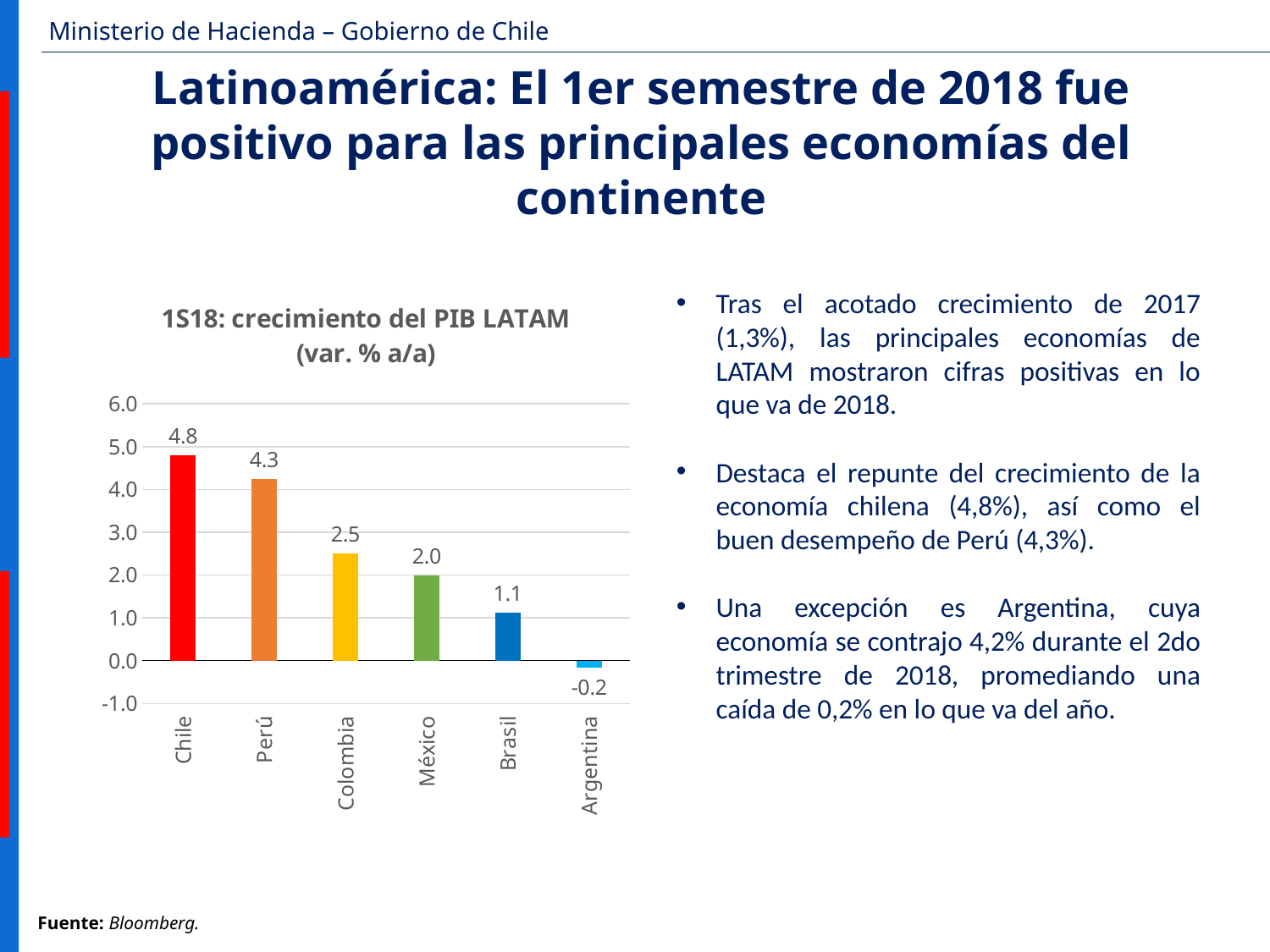
Is the value for Colombia greater or less than 3.0? less What is the value for Perú in the chart? 4.3 What is the difference between the values for Chile and Perú? 0.5 How many countries are shown in the chart? 6 What is the value for Argentina in the chart? -0.2 Which is larger, the value for México or the value for Brasil? México What is the title of the chart? 1S18: crecimiento del PIB LATAM (var. % a/a) What kind of chart is shown on the slide? bar chart What is the value for Chile in the chart? 4.8 Which country has the lowest value in the chart? Argentina Which country has the highest value in the chart? Chile What is the difference between the values for Colombia and Brasil? 1.4